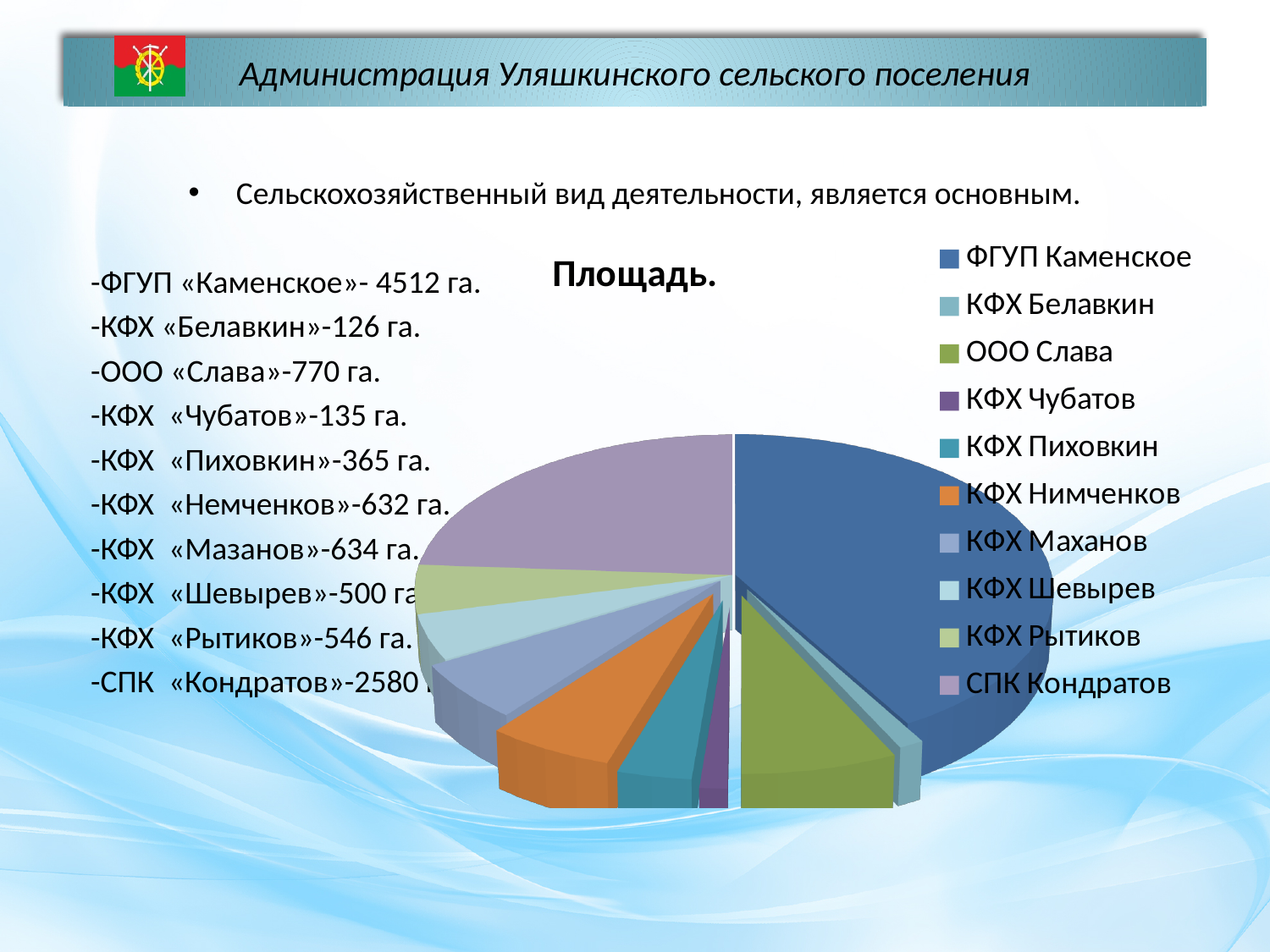
What is the area for КФХ Шевырев? 500 га What colour is the slice for ФГУП Каменское? blue What is the area for ООО Слава? 770 га What kind of chart is shown on the slide? pie chart What is the area for СПК Кондратов? 2580 га Which category has the largest slice of the pie? ФГУП Каменское How many entries does the chart legend list? 10 Which is larger, the slice for СПК Кондратов or the slice for ООО Слава? СПК Кондратов What is the difference in area between ФГУП Каменское and СПК Кондратов? 1932 га What is the title of the chart? Площадь. What is the area for ФГУП Каменское? 4512 га What is the area for КФХ Белавкин? 126 га